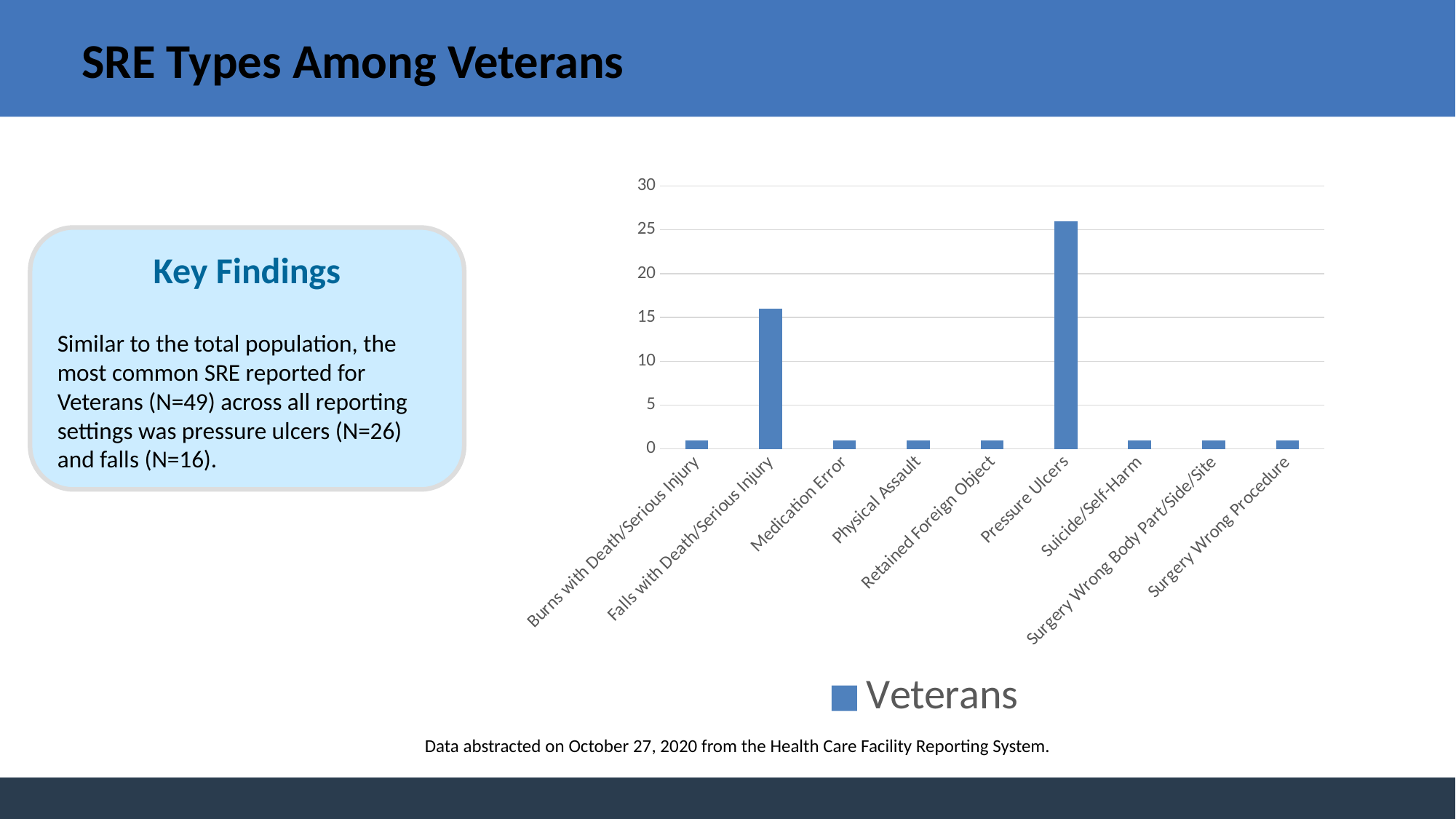
How many series does the chart legend list? 1 Which SRE type has the highest value in the chart? Pressure Ulcers Is the value for Falls with Death/Serious Injury greater or less than 10? greater Which is larger in the chart, the value for Falls with Death/Serious Injury or the value for Medication Error? Falls with Death/Serious Injury What is the title of the slide containing the chart? SRE Types Among Veterans Which is larger in the chart, the value for Pressure Ulcers or the value for Falls with Death/Serious Injury? Pressure Ulcers How many SRE type categories are shown on the x axis of the chart? 9 What kind of chart is shown on the slide? bar chart Is the value for Pressure Ulcers greater or less than 20? greater Is the value for Medication Error greater or less than 5? less What series name is shown in the chart legend? Veterans